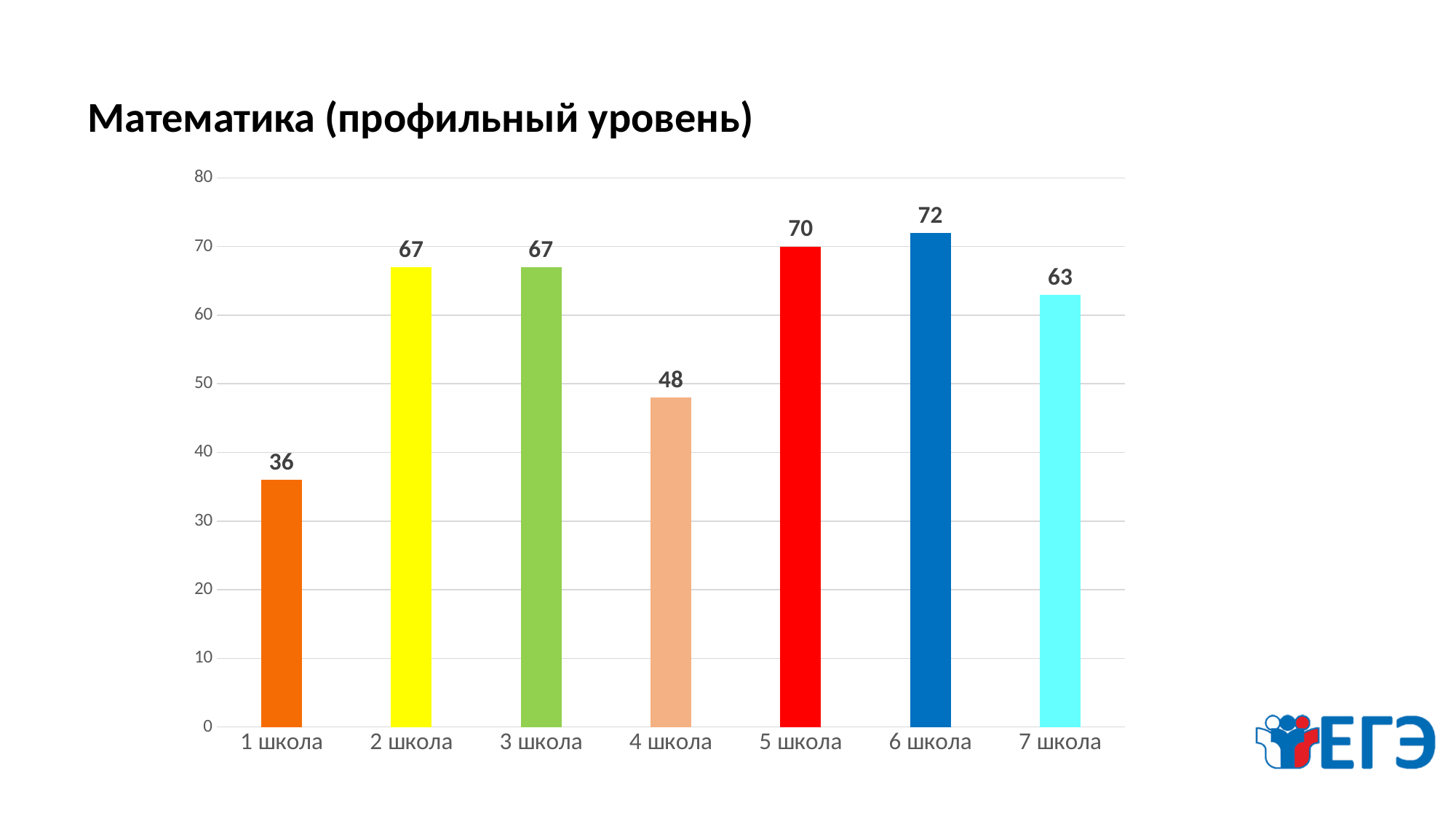
Which school has the highest value? 6 школа What kind of chart is shown on the slide? bar chart Is the value for 4 школа greater or less than 50? less Which school has the lowest value? 1 школа What is the difference between the values for 5 школа and 4 школа? 22 What is the value for 7 школа? 63 What is the title of the slide? Математика (профильный уровень) What is the value for 1 школа? 36 What is the difference between the values for 6 школа and 1 школа? 36 How many schools are shown on the chart? 7 Which is larger, the value for 5 школа or the value for 7 школа? 5 школа What is the value for 4 школа? 48